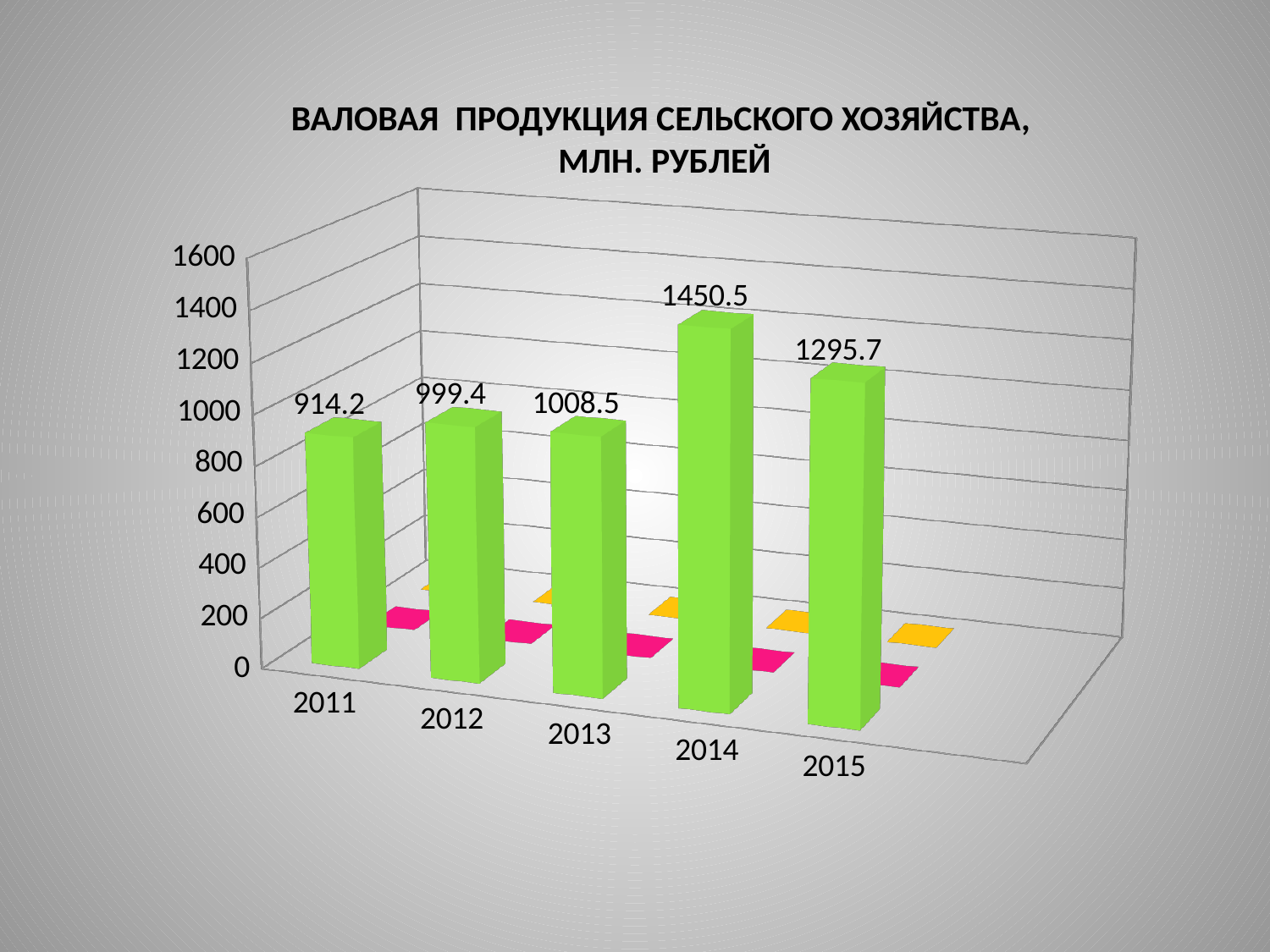
What is the value for 2015? 1295.7 Which year has the highest value? 2014 What is the value for 2014? 1450.5 What is the difference between the values for 2012 and 2011? 85.2 Which year has the lowest value? 2011 How many years are shown on the x axis? 5 Do the values rise or fall from 2011 to 2014? rise What is the difference between the values for 2014 and 2015? 154.8 Is the value for 2014 greater or less than 1400? greater What kind of chart is shown on the slide? bar chart What is the value for 2011? 914.2 Which is larger, the value for 2012 or the value for 2013? 2013